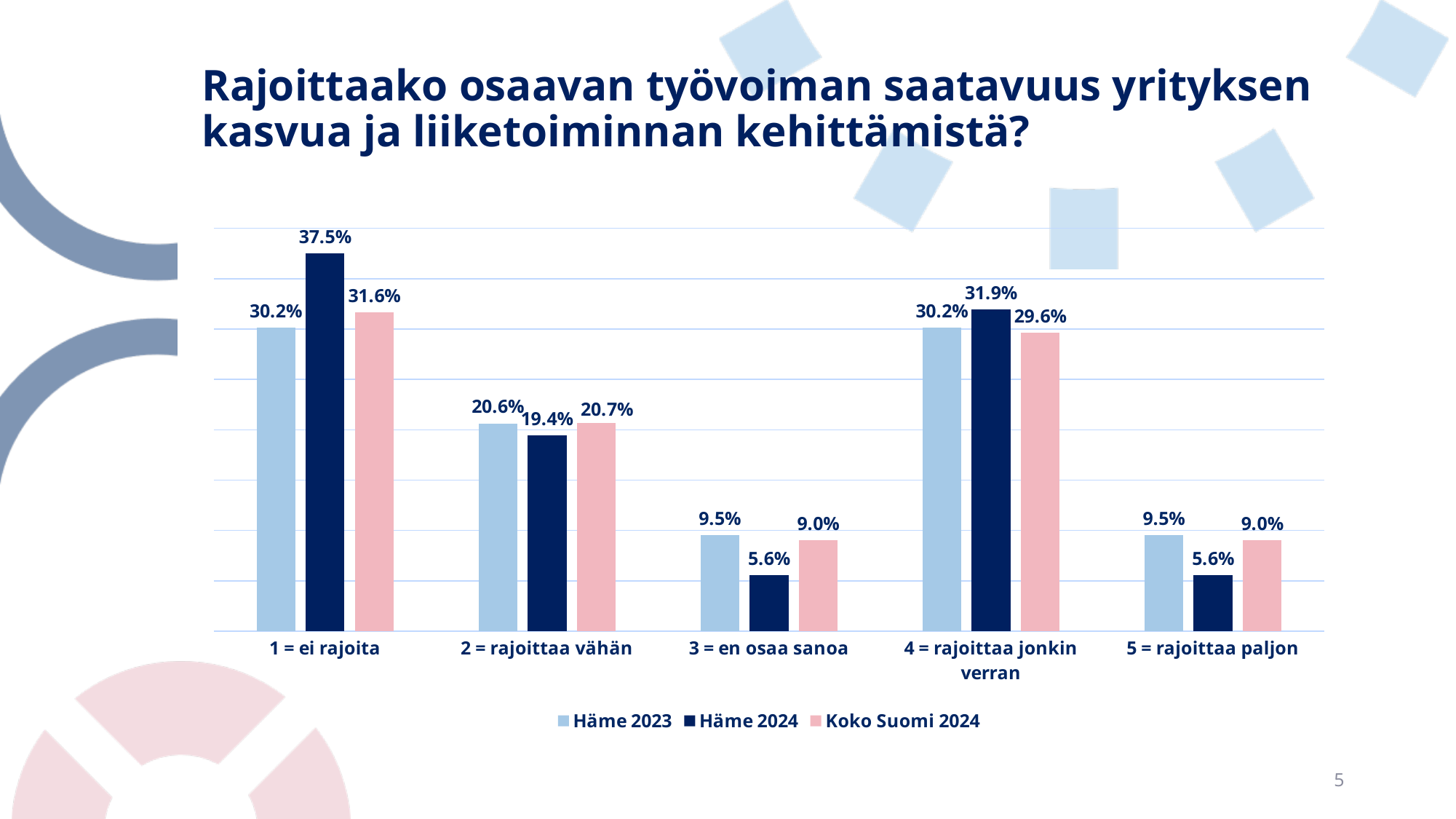
What is the value for Häme 2024 in the category "1 = ei rajoita"? 37.5% What kind of chart is shown on the slide? Bar chart What is the value for Häme 2024 in the category "5 = rajoittaa paljon"? 5.6% What is the value for Koko Suomi 2024 in the category "2 = rajoittaa vähän"? 20.7% What is the difference between Häme 2024 and Häme 2023 in the category "1 = ei rajoita"? 7.3 percentage points Which category has the highest value for Häme 2024? 1 = ei rajoita Which category has the lowest value for Koko Suomi 2024? 3 = en osaa sanoa and 5 = rajoittaa paljon (both 9.0%) How many categories are shown on the x axis? 5 In the category "4 = rajoittaa jonkin verran", which series has the larger value, Häme 2024 or Koko Suomi 2024? Häme 2024 Which series is shown in pink in the legend? Koko Suomi 2024 How many series does the legend list? 3 What is the value for Häme 2023 in the category "3 = en osaa sanoa"? 9.5%